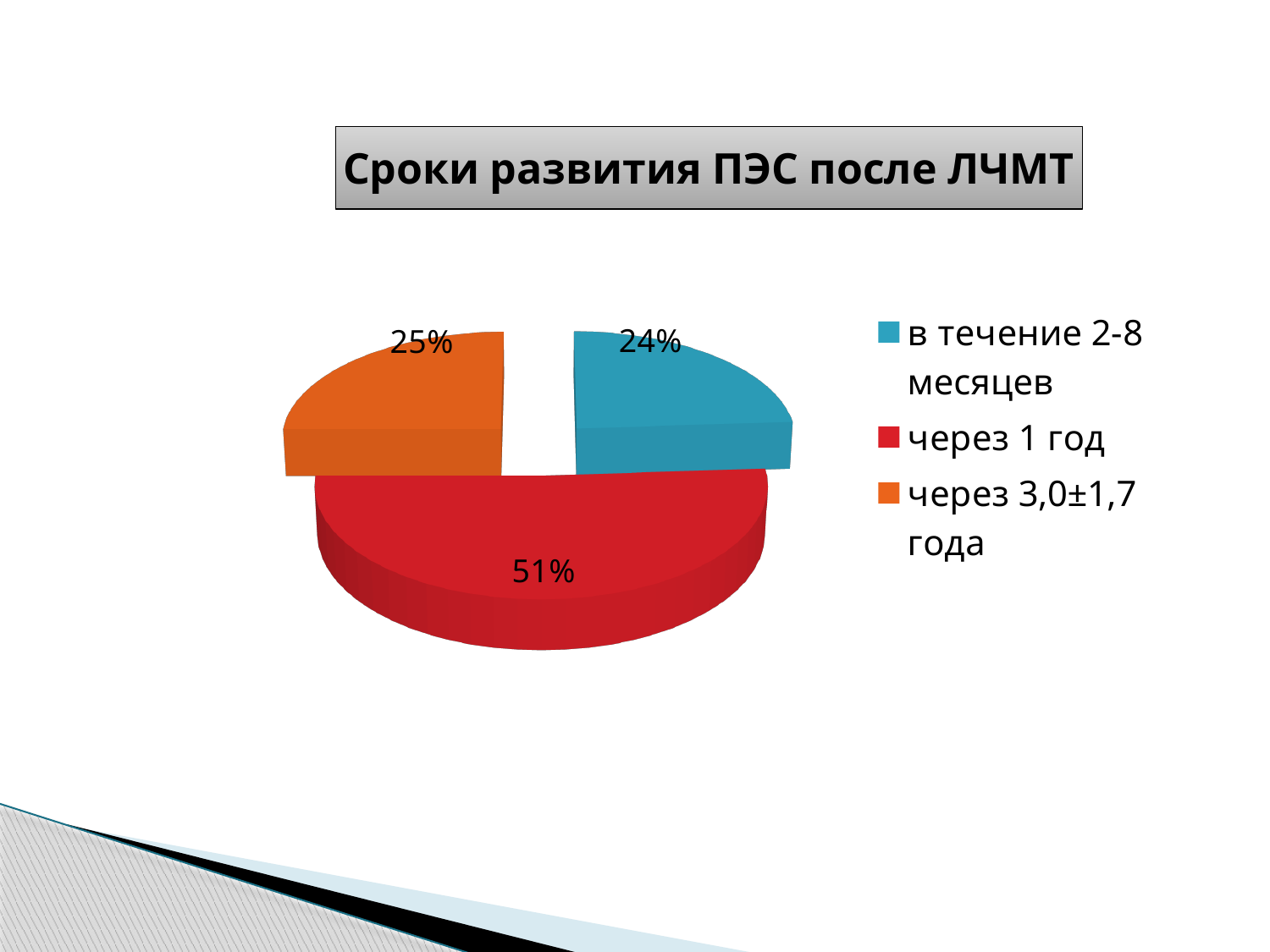
What share of the pie does "в течение 2-8 месяцев" represent? 24% What share of the pie does "через 1 год" represent? 51% How many slices does the pie chart have? 3 Which category has the smallest share of the pie? в течение 2-8 месяцев Which is larger: the share for "через 1 год" or the share for "через 3,0±1,7 года"? через 1 год What colour is the slice for "через 1 год"? red What is the title of the chart? Сроки развития ПЭС после ЛЧМТ What share of the pie does "через 3,0±1,7 года" represent? 25% Which category has the largest share of the pie? через 1 год What is the difference between the shares for "через 1 год" and "в течение 2-8 месяцев"? 27% What type of chart is shown on the slide? pie chart How many entries does the legend list? 3